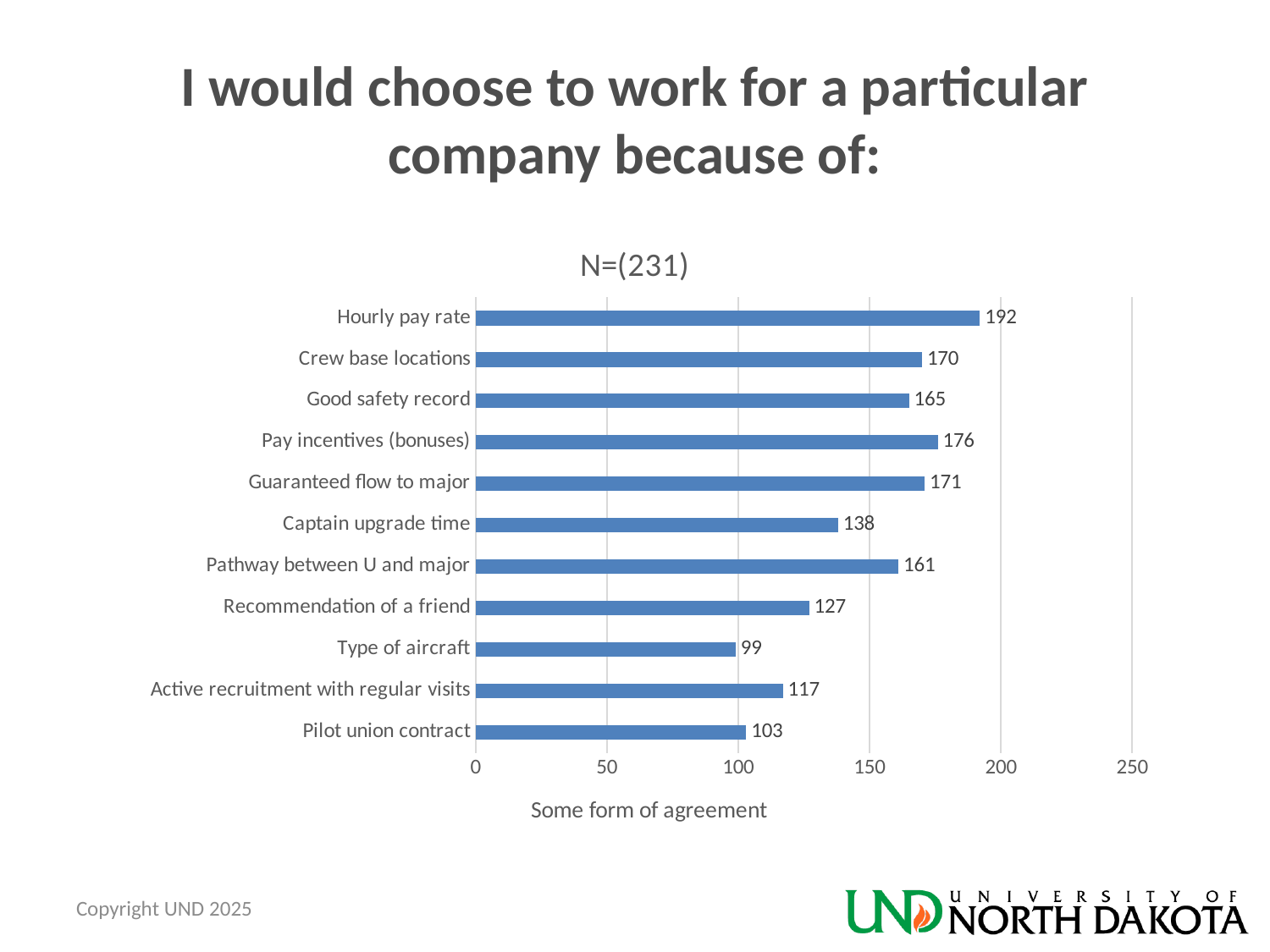
What kind of chart is shown on the slide? Bar chart What is the value for Active recruitment with regular visits? 117 Which category has the lowest value? Type of aircraft What is the difference between the values for Pay incentives (bonuses) and Good safety record? 11 What is the difference between the values for Hourly pay rate and Pilot union contract? 89 What is the value for Captain upgrade time? 138 Which is larger, the value for Recommendation of a friend or the value for Pathway between U and major? Pathway between U and major What is the label on the horizontal axis of the chart? Some form of agreement Is the value for Crew base locations greater or less than 150? greater Which category has the highest value? Hourly pay rate What is the value for Hourly pay rate? 192 How many categories are shown in the chart? 11